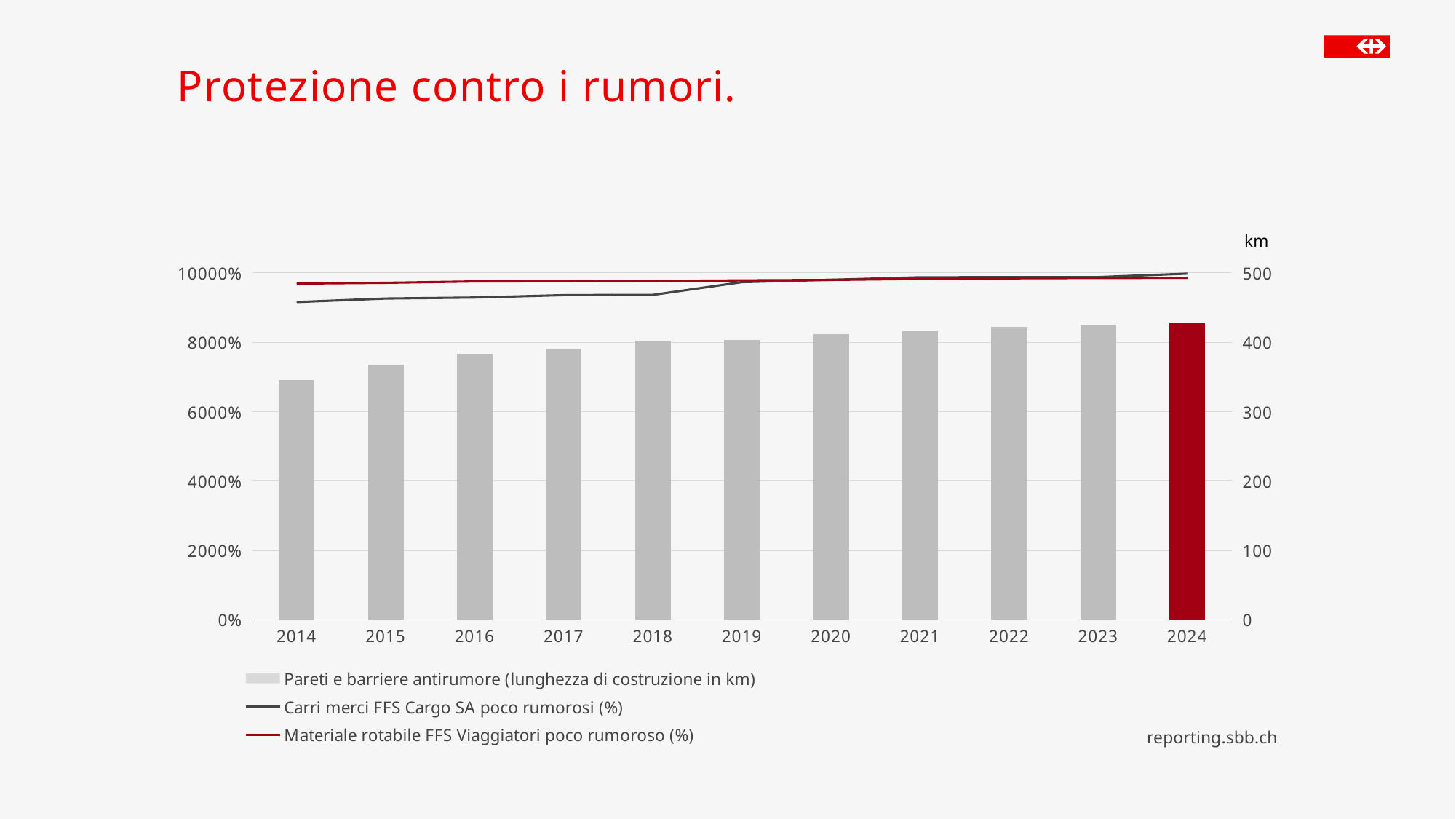
What kind of chart is shown on the slide? A combined bar and line chart Which year has the highest bar for 'Pareti e barriere antirumore'? 2024 How many series does the legend list? 3 Which is larger: the 'Pareti e barriere antirumore' bar for 2024 or for 2014? 2024 What is the title of the chart on the slide? Protezione contro i rumori. Is the bar for 'Pareti e barriere antirumore' in 2014 greater or less than 400 km? less What colour is the bar for 2024? Red Is the value of 'Carri merci FFS Cargo SA poco rumorosi (%)' in 2014 greater or less than 10000%? less Is the bar for 'Pareti e barriere antirumore' in 2024 greater or less than 400 km? greater How many years are shown on the x axis? 11 Do the bars for 'Pareti e barriere antirumore' rise or fall from 2014 to 2024? Rise Which year has the lowest bar for 'Pareti e barriere antirumore'? 2014